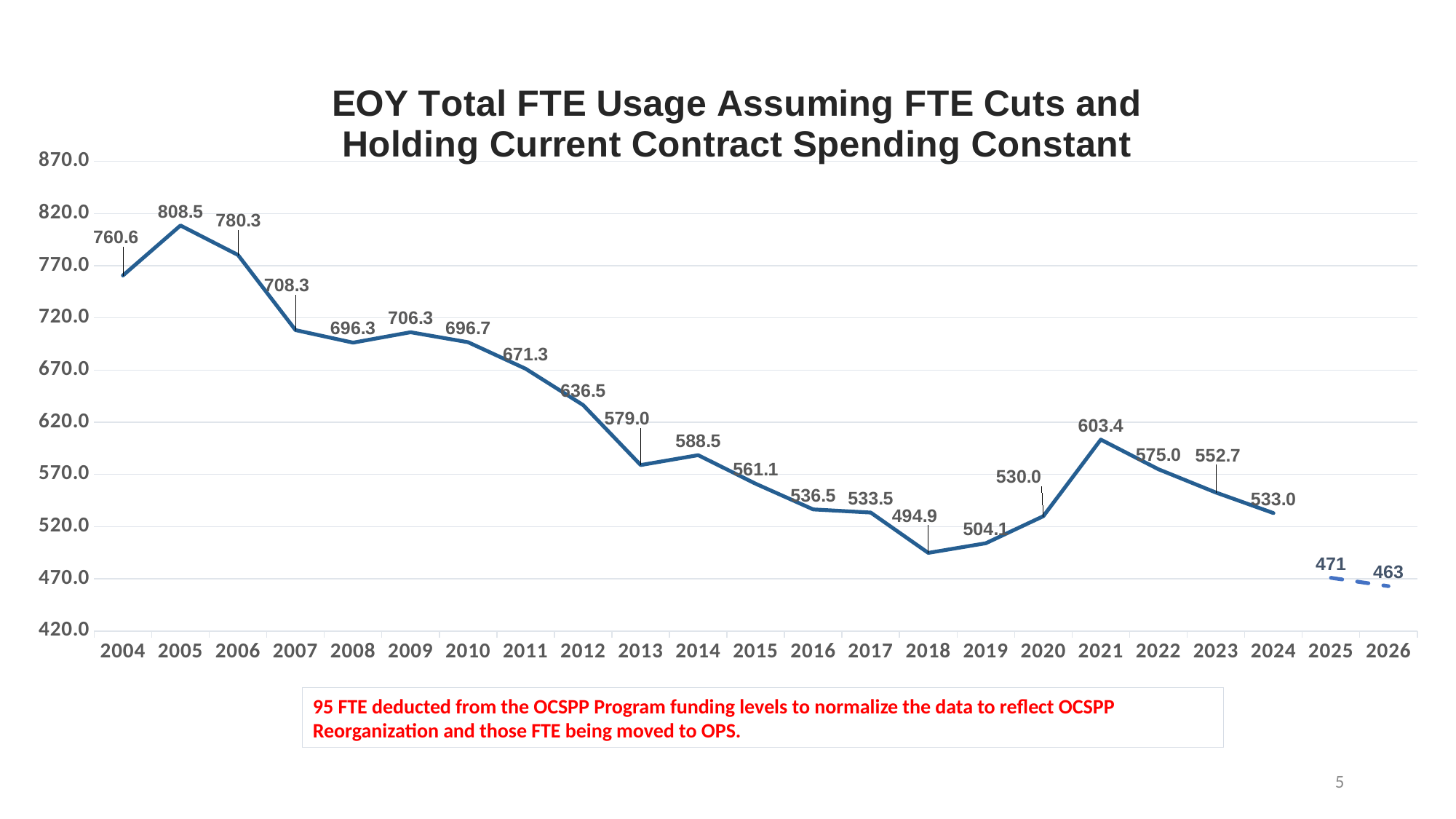
Do the values generally rise or fall from 2004 to 2026? fall Which is larger, the value for 2013 or the value for 2014? 2014 What is the value for 2026? 463 What is the difference between the values for 2021 and 2020? 73.4 What is the value for 2018? 494.9 What kind of chart is this? line chart What is the difference between the values for 2005 and 2004? 47.9 How many years are shown on the x axis? 23 Is the value for 2018 greater or less than 520? less Which year has the lowest value? 2026 Which year has the highest value? 2005 What is the value for 2005? 808.5